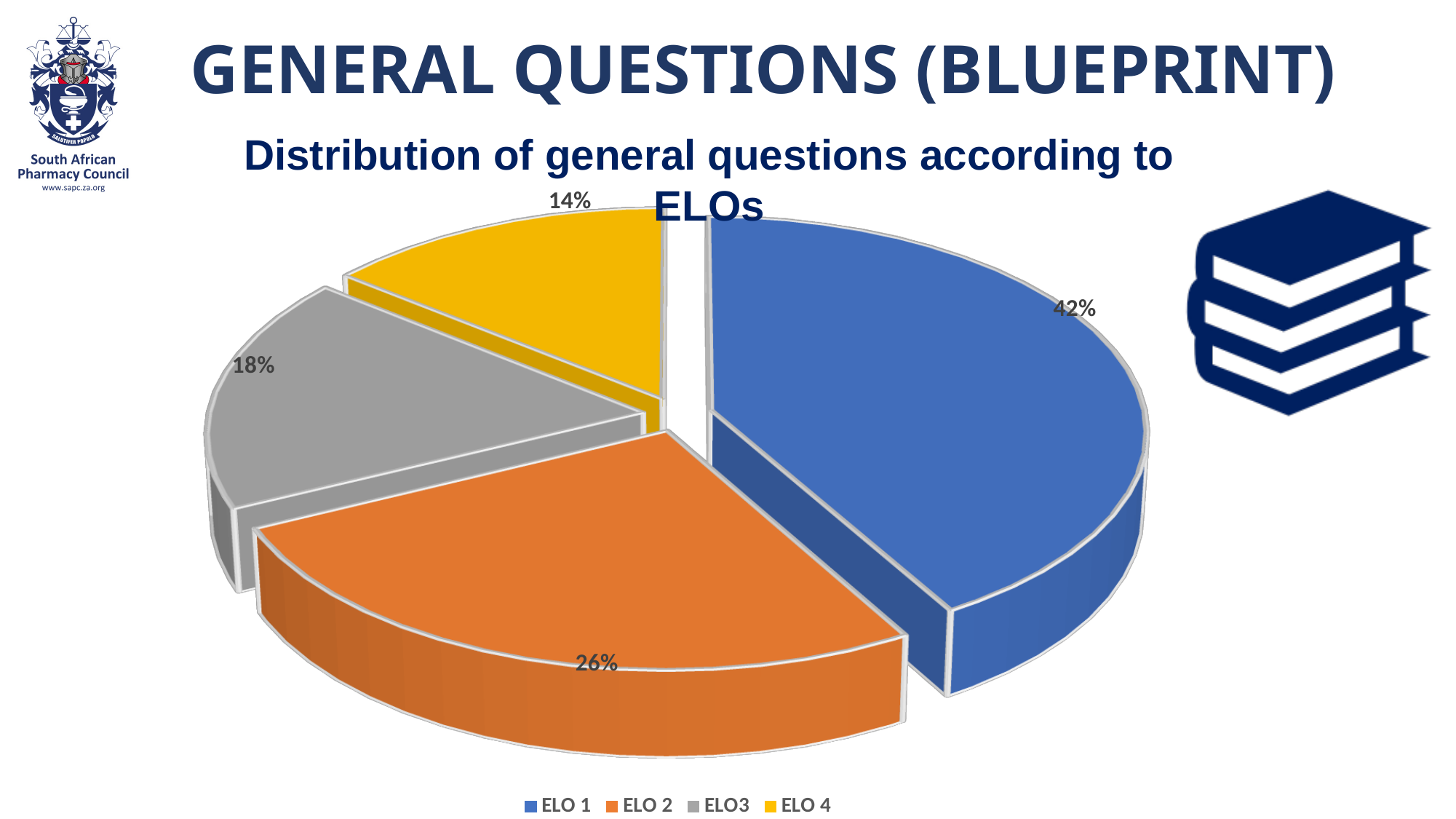
What share of general questions is allocated to ELO 1? 42% What share of general questions is allocated to ELO 2? 26% What is the difference in percentage points between the shares for ELO3 and ELO 4? 4 Which has a larger share of general questions, ELO 2 or ELO3? ELO 2 What kind of chart is shown on the slide? Pie chart How many slices does the pie chart have? 4 What share of general questions is allocated to ELO3? 18% What share of general questions is allocated to ELO 4? 14% What colour is the slice for ELO 4? Yellow What is the difference in percentage points between the shares for ELO 1 and ELO 2? 16 Which ELO has the smallest share of general questions? ELO 4 Which ELO has the largest share of general questions? ELO 1